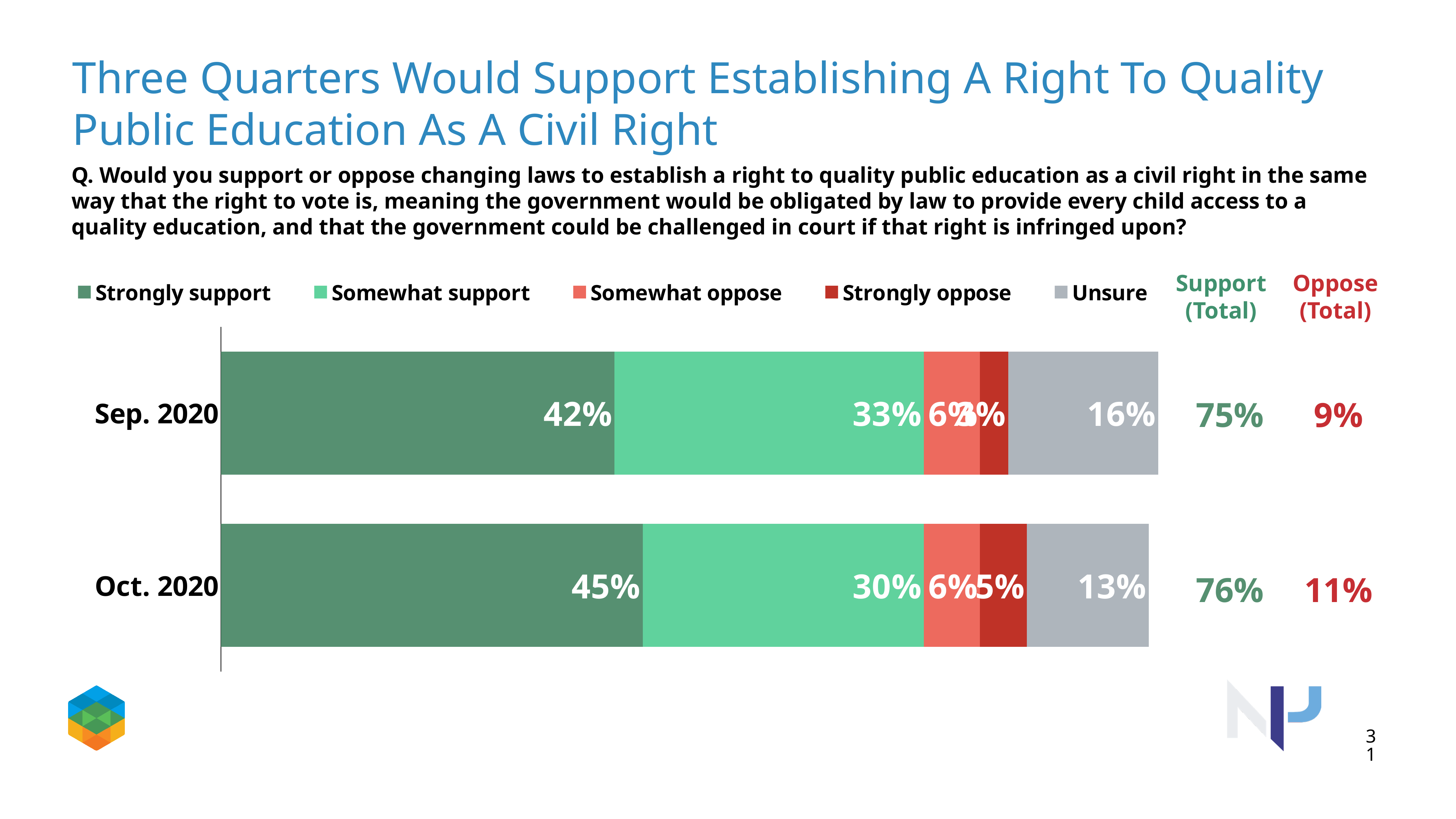
What kind of chart is shown on the slide? Stacked bar chart What is the Somewhat support value for Oct. 2020? 30% Which period has the higher Strongly support value, Sep. 2020 or Oct. 2020? Oct. 2020 How many categories (time periods) are plotted in the chart? 2 What is the difference between the Unsure values for Sep. 2020 and Oct. 2020? 3% Which legend entry is shown in grey? Unsure What is the Oppose (Total) value for Sep. 2020? 9% What is the Strongly oppose value for Oct. 2020? 5% What is the Support (Total) value for Oct. 2020? 76% What is the Strongly support value for Sep. 2020? 42% What is the Unsure value for Sep. 2020? 16% How many series does the legend list? 5